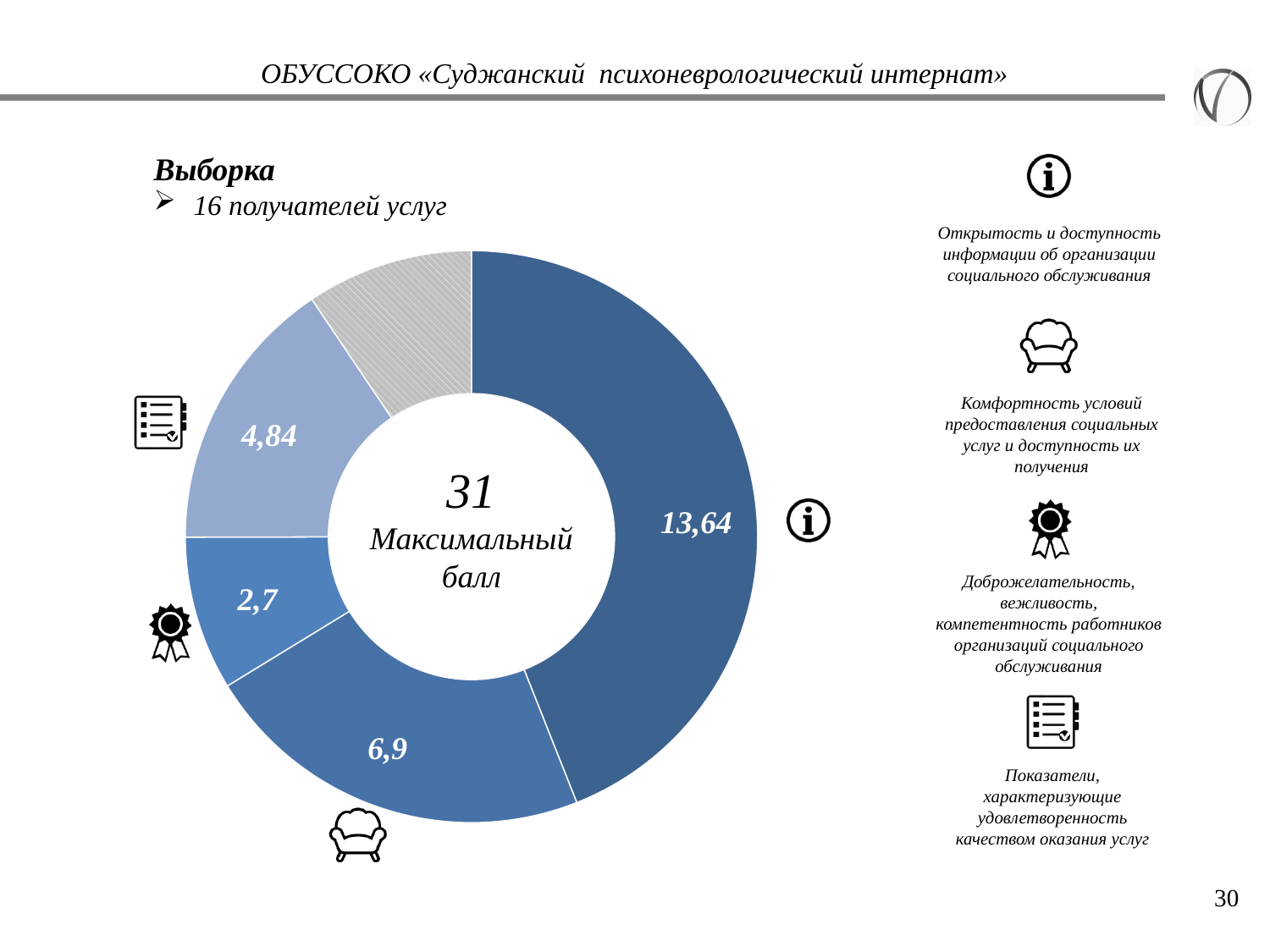
What value is shown for the slice marked with the medal icon (Доброжелательность, вежливость, компетентность работников)? 2,7 Which labeled slice has the highest value? 13,64 (Открытость и доступность информации) What is the difference between the largest labeled slice (13,64) and the smallest labeled slice (2,7)? 10,94 Which is larger: the value for the armchair icon slice or the value for the checklist icon slice? The armchair icon slice (6,9) How many slices of the doughnut have a printed value label? 4 How many service recipients are in the sample (Выборка) stated on the slide? 16 What value is shown for the slice marked with the armchair icon (Комфортность условий предоставления социальных услуг и доступность их получения)? 6,9 What value is shown for the slice marked with the checklist icon (Показатели, характеризующие удовлетворенность качеством оказания услуг)? 4,84 What type of chart is shown on the slide? Doughnut chart What value is shown for the slice marked with the information icon (Открытость и доступность информации об организации социального обслуживания)? 13,64 What maximum score is shown in the centre of the doughnut chart? 31 Which labeled slice has the lowest value? 2,7 (Доброжелательность, вежливость, компетентность работников)